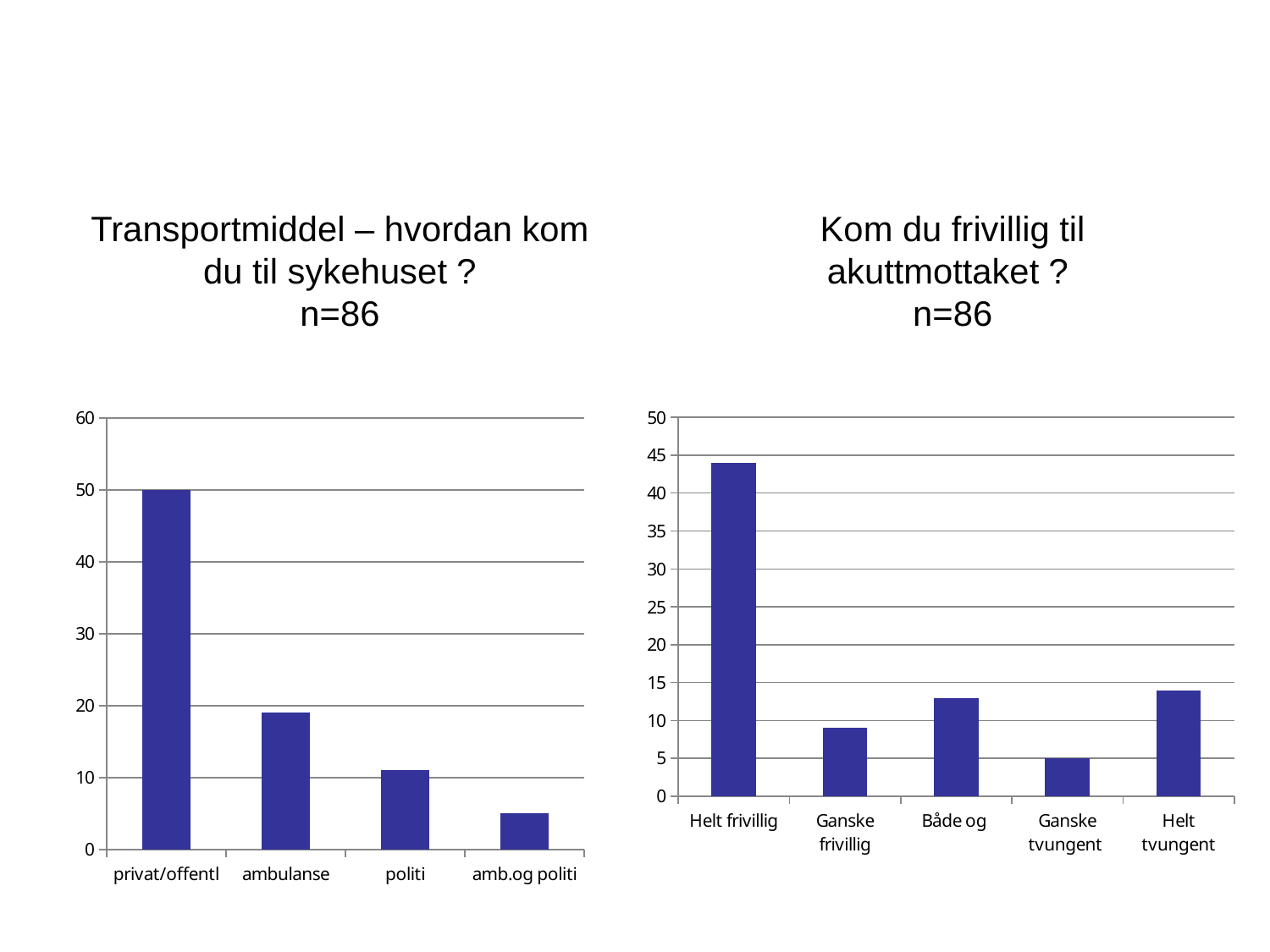
In the right chart (Kom du frivillig til akuttmottaket?), which category has the lowest value? Ganske tvungent In the right chart (Kom du frivillig til akuttmottaket?), is the value for Helt frivillig greater or less than 40? greater In the right chart (Kom du frivillig til akuttmottaket?), which is larger, Ganske frivillig or Helt tvungent? Helt tvungent How many categories are shown in the left chart (Transportmiddel)? 4 In the right chart (Kom du frivillig til akuttmottaket?), which category has the highest value? Helt frivillig In the right chart (Kom du frivillig til akuttmottaket?), what is the value for Ganske tvungent? 5 In the left chart (Transportmiddel), which category has the lowest value? amb.og politi How many categories are shown in the right chart (Kom du frivillig til akuttmottaket?)? 5 What kind of chart is the left chart (Transportmiddel)? bar chart In the left chart (Transportmiddel), which category has the highest value? privat/offentl In the left chart (Transportmiddel), what is the value for privat/offentl? 50